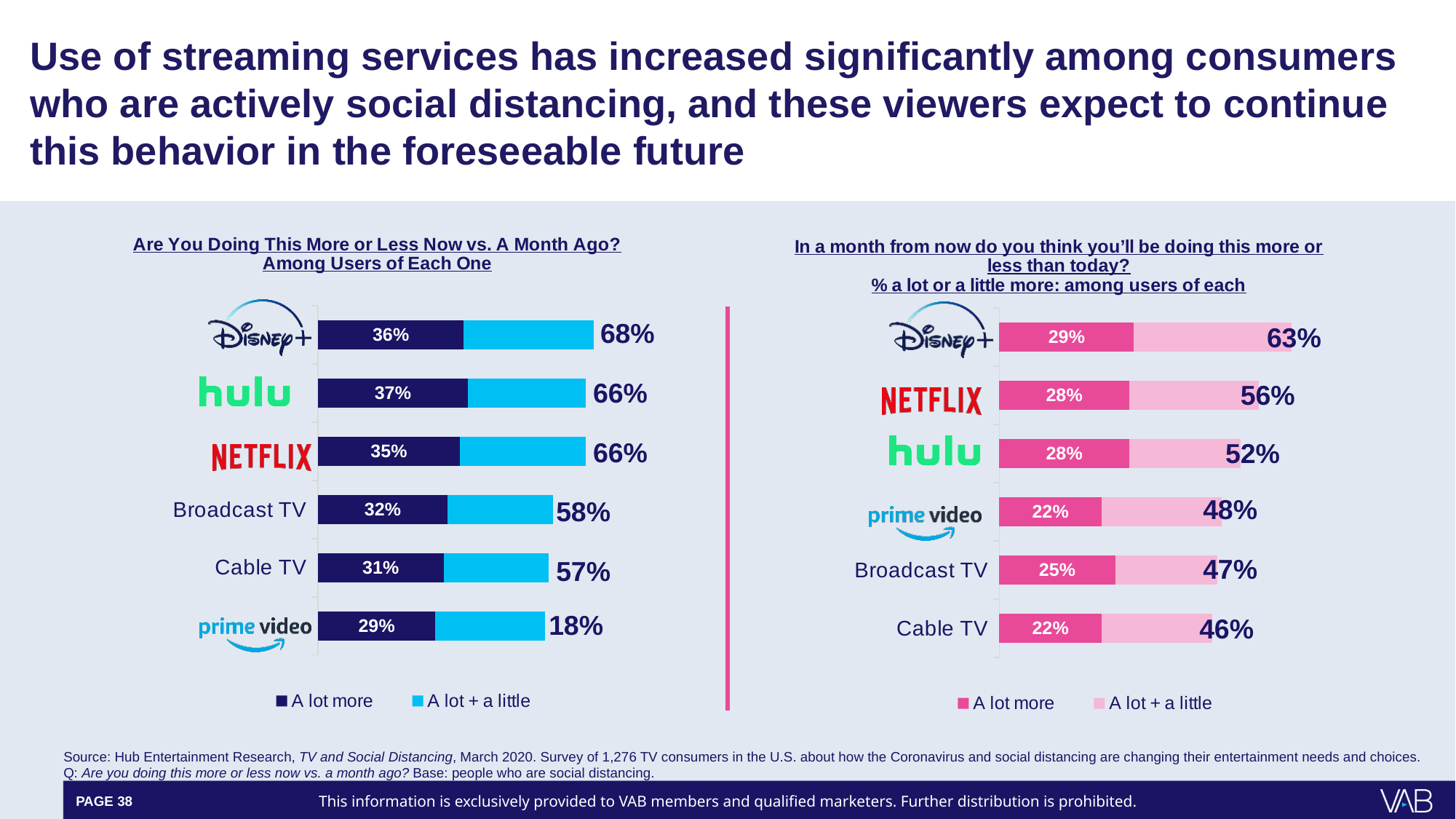
In the right chart (In a month from now do you think you'll be doing this more or less than today?), what is the 'A lot + a little' value for Netflix? 56% How many series does the legend of the right chart list? 2 In the left chart (Are You Doing This More or Less Now vs. A Month Ago?), what is the 'A lot more' value for Hulu? 37% In the right chart (In a month from now do you think you'll be doing this more or less than today?), what is the 'A lot more' value for Broadcast TV? 25% In the left chart (Are You Doing This More or Less Now vs. A Month Ago?), what is the difference between the 'A lot + a little' values for Disney+ and Cable TV? 11% In the left chart (Are You Doing This More or Less Now vs. A Month Ago?), what is the 'A lot + a little' value for Disney+? 68% In the right chart (In a month from now do you think you'll be doing this more or less than today?), which category has the lowest 'A lot + a little' value? Cable TV In the right chart (In a month from now do you think you'll be doing this more or less than today?), which is larger, the 'A lot + a little' value for Hulu or for Prime Video? Hulu In the left chart (Are You Doing This More or Less Now vs. A Month Ago?), how many categories are shown? 6 What kind of chart is the left chart (Are You Doing This More or Less Now vs. A Month Ago?)? Bar chart In the right chart (In a month from now do you think you'll be doing this more or less than today?), what is the difference between the 'A lot + a little' values for Disney+ and Netflix? 7% In the left chart (Are You Doing This More or Less Now vs. A Month Ago?), which category has the highest 'A lot more' value? Hulu